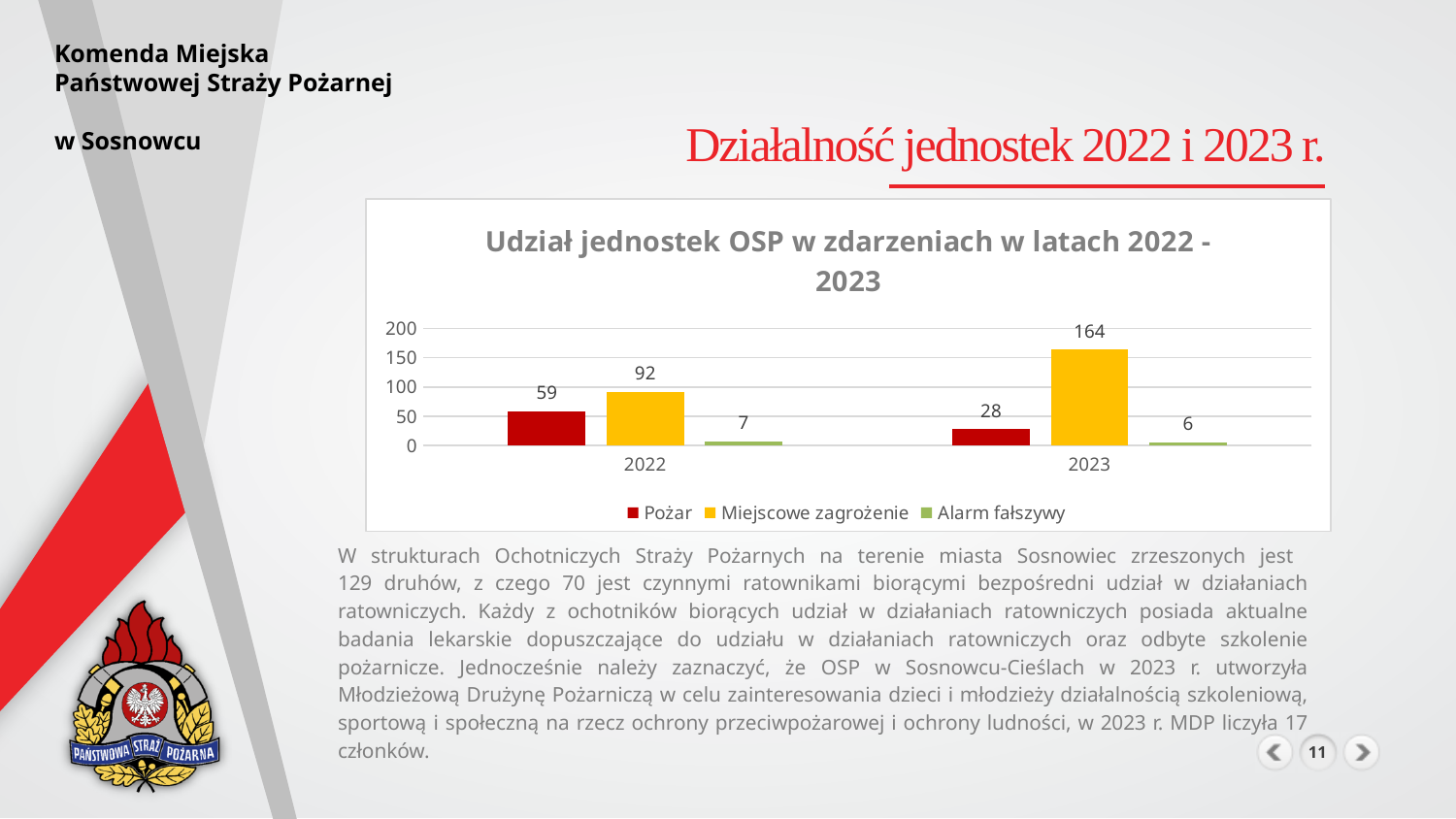
Which is larger: Pożar in 2022 or Pożar in 2023? Pożar in 2022 What is the value for Alarm fałszywy in 2022? 7 How many series does the legend list? 3 What is the title of the chart? Udział jednostek OSP w zdarzeniach w latach 2022 - 2023 Is the value for Miejscowe zagrożenie in 2023 greater or less than 150? greater What is the value for Miejscowe zagrożenie in 2023? 164 How many year categories are shown on the x axis? 2 Which series has the highest value in 2023? Miejscowe zagrożenie What is the difference between Miejscowe zagrożenie in 2023 and in 2022? 72 What kind of chart is shown on the slide? Bar chart Which series has the lowest value in 2022? Alarm fałszywy What is the value for Pożar in 2022? 59